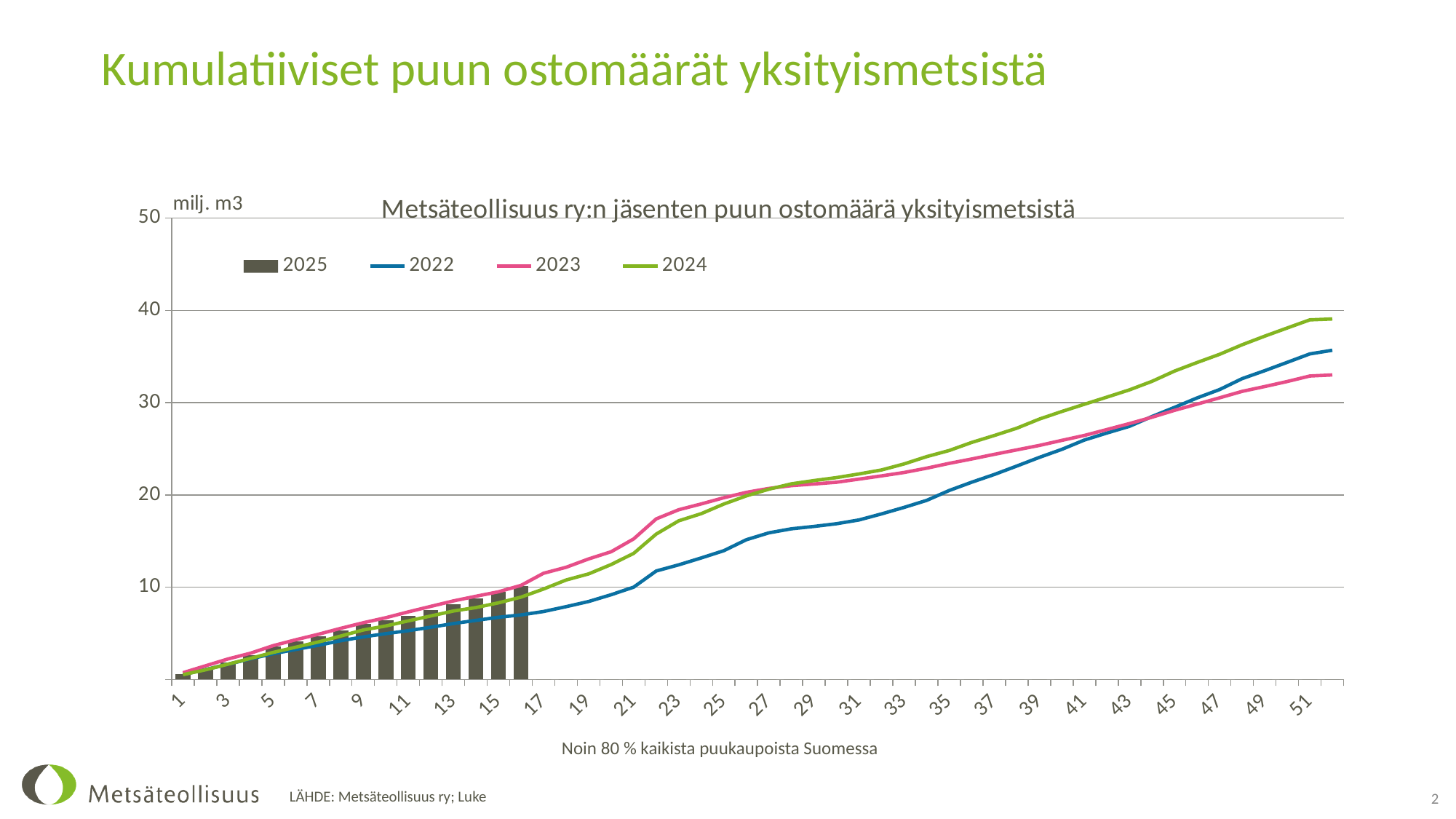
At week 35, which is larger: the 2023 line or the 2022 line? 2023 Is the value of the 2024 line at week 51 greater or less than 30? greater Is the value of the 2022 line at week 27 greater or less than 20? less How many series does the chart legend list? 4 Do the values of the 2024 line rise or fall along the x axis? rise Which line series has the lowest value at the end of the x axis (week 52)? 2023 Is the value of the 2025 bar at week 9 greater or less than 10? less What is the title of the chart? Metsäteollisuus ry:n jäsenten puun ostomäärä yksityismetsistä Which series has the highest value at the end of the x axis (week 52)? 2024 Which series is drawn as bars rather than a line? 2025 How many bars are plotted for the 2025 series? 16 What kind of chart is this? Combined bar and line chart